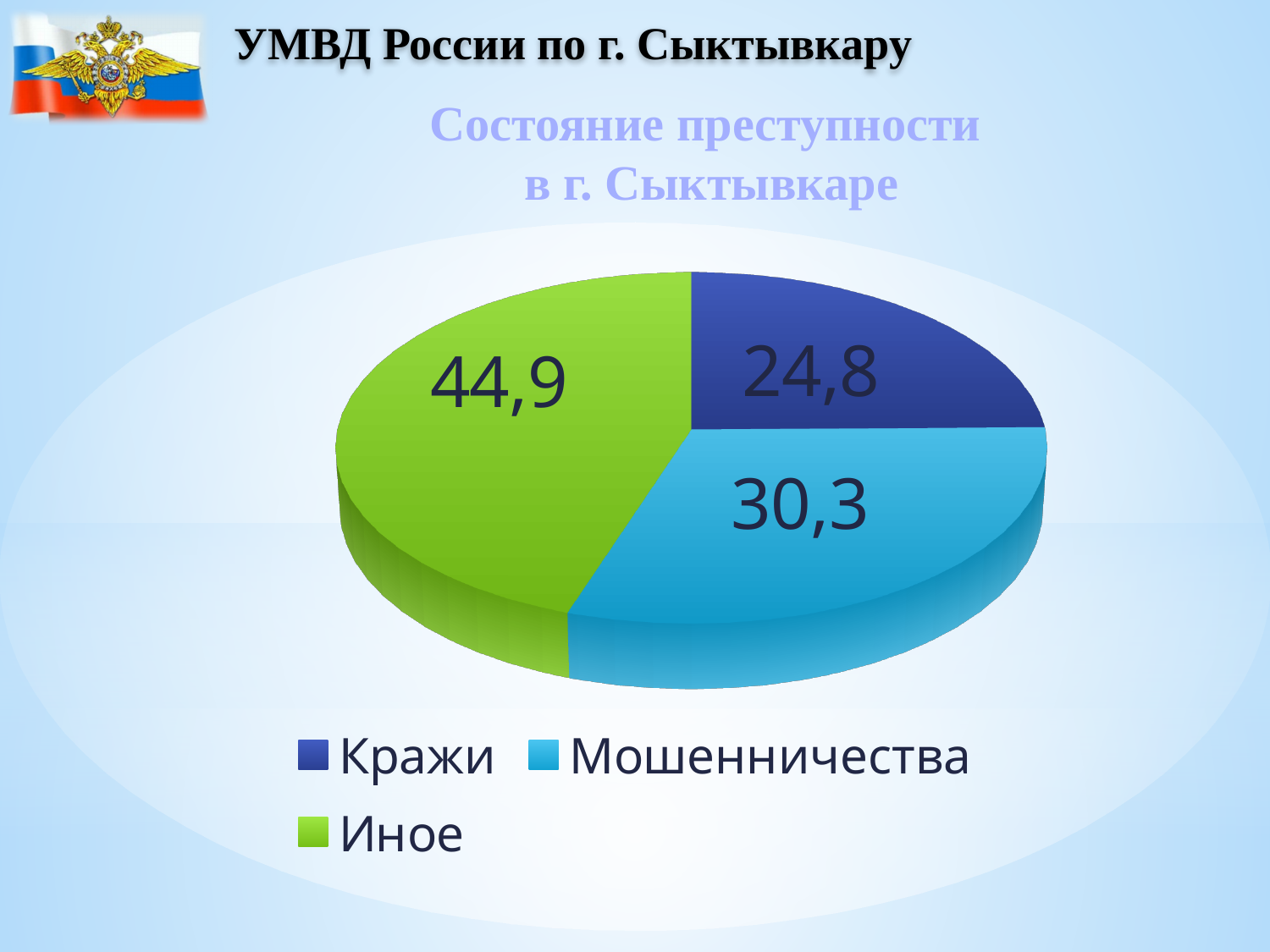
What kind of chart is shown on the slide? Pie chart What value is shown for Мошенничества? 30,3 Which category has the largest slice? Иное What is the difference between the values for Иное and Кражи? 20,1 What is the title of the chart? Состояние преступности в г. Сыктывкаре What value is shown for Кражи? 24,8 Which category has the smallest slice? Кражи How many slices does the pie chart have? 3 Which colour represents Иное in the legend? Green What value is shown for Иное? 44,9 What is the difference between the values for Мошенничества and Кражи? 5,5 Which is larger, Мошенничества or Кражи? Мошенничества